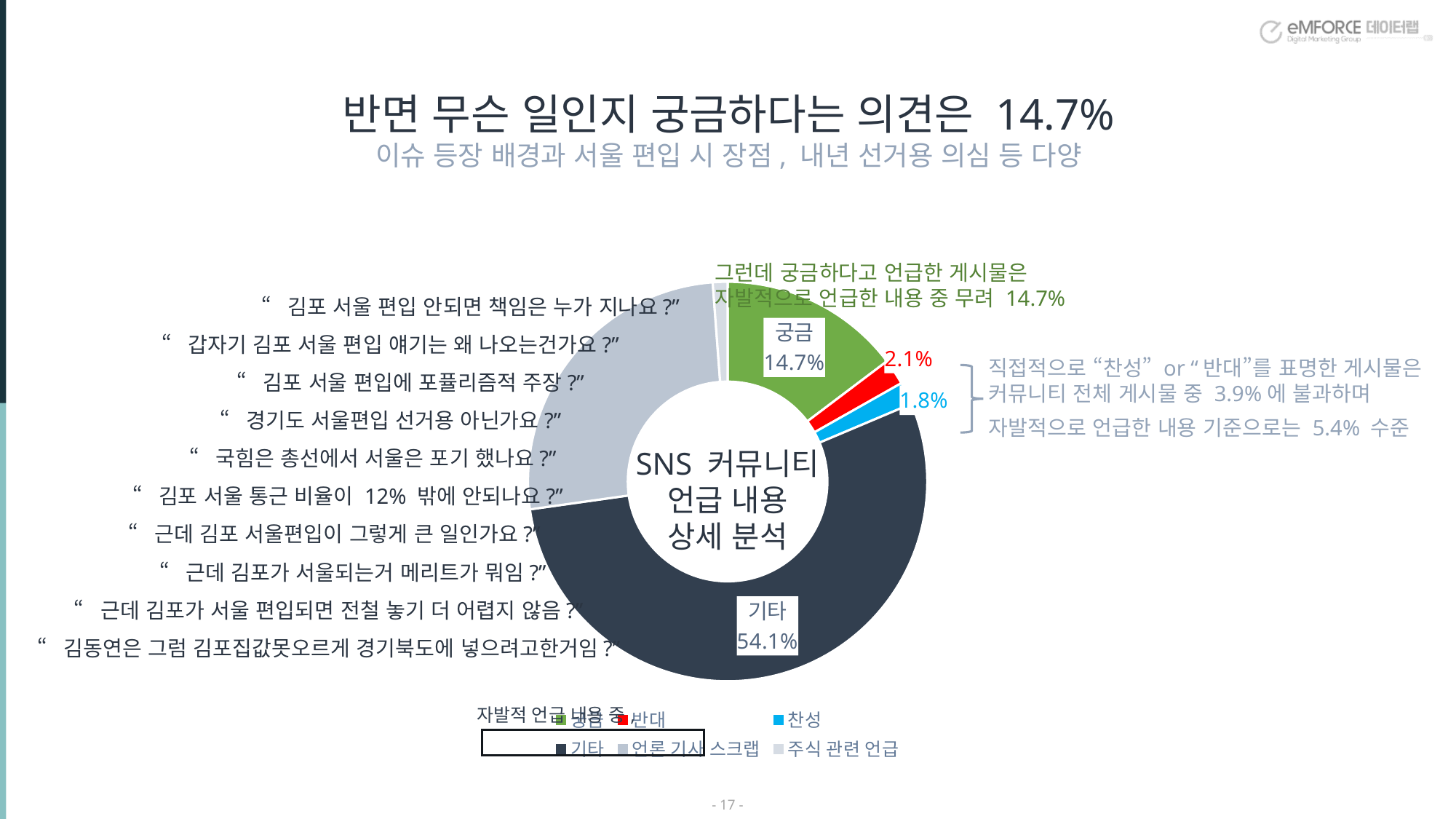
What kind of chart is shown on the slide? Doughnut (pie) chart How many categories does the chart legend list? 6 Which is larger, the 반대 slice or the 찬성 slice? 반대 What is the difference in percentage points between the 기타 slice and the 궁금 slice? 39.4 percentage points What percentage is shown for the 반대 (red) slice? 2.1% What is the difference in percentage points between the 반대 slice and the 찬성 slice? 0.3 percentage points What title is written in the center of the doughnut chart? SNS 커뮤니티 언급 내용 상세 분석 Which category has the smallest share of the doughnut chart? 주식 관련 언급 What percentage does the 기타 slice represent? 54.1% Which category has the largest share of the doughnut chart? 기타 What percentage does the 궁금 slice represent? 14.7% What percentage is shown for the 찬성 (blue) slice? 1.8%